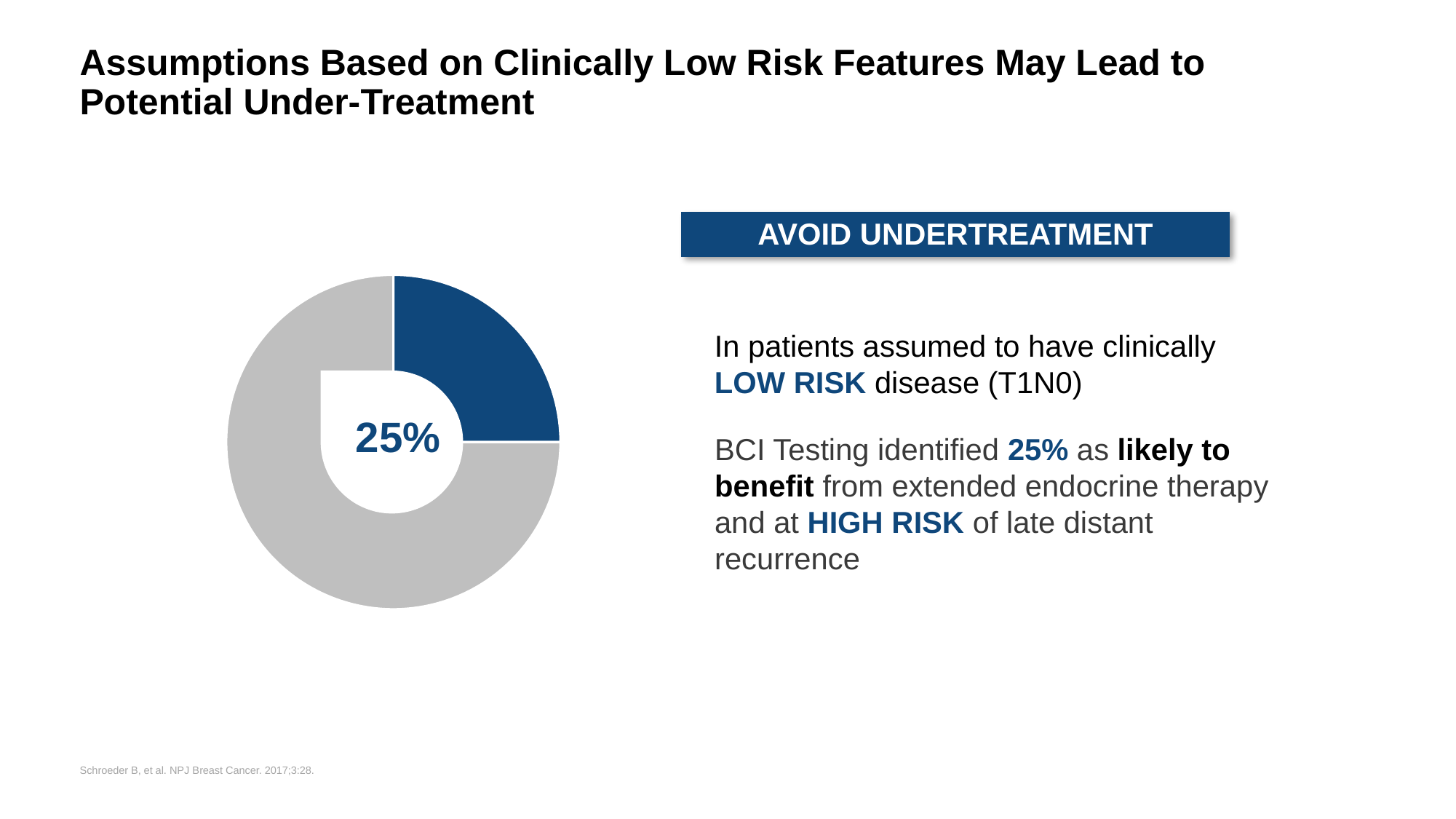
What colour is the slice representing the 25% of patients identified by BCI Testing as likely to benefit? Blue Is the blue slice of the donut chart greater or less than 50% of the whole? less What kind of chart is shown on the slide? Donut (pie) chart What share of the donut chart does the blue slice represent? 25% What percentage is printed in the centre of the donut chart? 25% Which slice of the donut chart is the smallest? The blue slice How many slices does the donut chart have? 2 Which slice of the donut chart is larger, the blue one or the grey one? The grey one What is the text in the blue header box to the right of the donut chart? AVOID UNDERTREATMENT